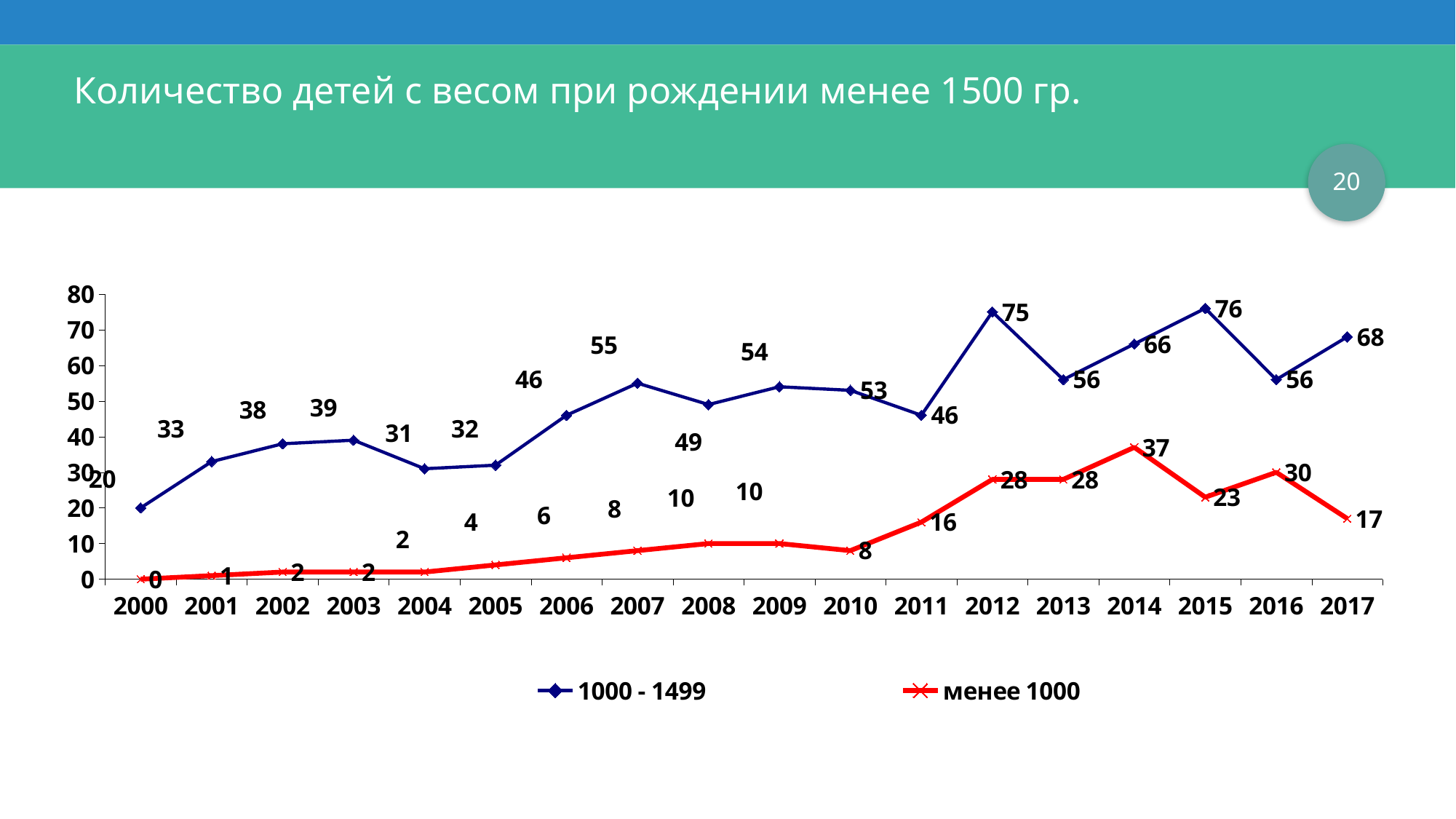
Which series has the larger value in 2013, "1000 - 1499" or "менее 1000"? 1000 - 1499 What is the title of the chart on the slide? Количество детей с весом при рождении менее 1500 гр. Does the series "менее 1000" generally rise or fall from 2000 to 2014? rise What type of chart is shown on the slide? line chart How many years are plotted along the x axis? 18 What is the value for the series "менее 1000" in 2014? 37 In which year does the series "менее 1000" have its lowest value? 2000 How many series does the legend list? 2 What is the value for the series "1000 - 1499" in 2000? 20 In which year does the series "1000 - 1499" reach its highest value? 2015 What is the value for the series "1000 - 1499" in 2012? 75 What is the difference between the "1000 - 1499" value and the "менее 1000" value in 2017? 51